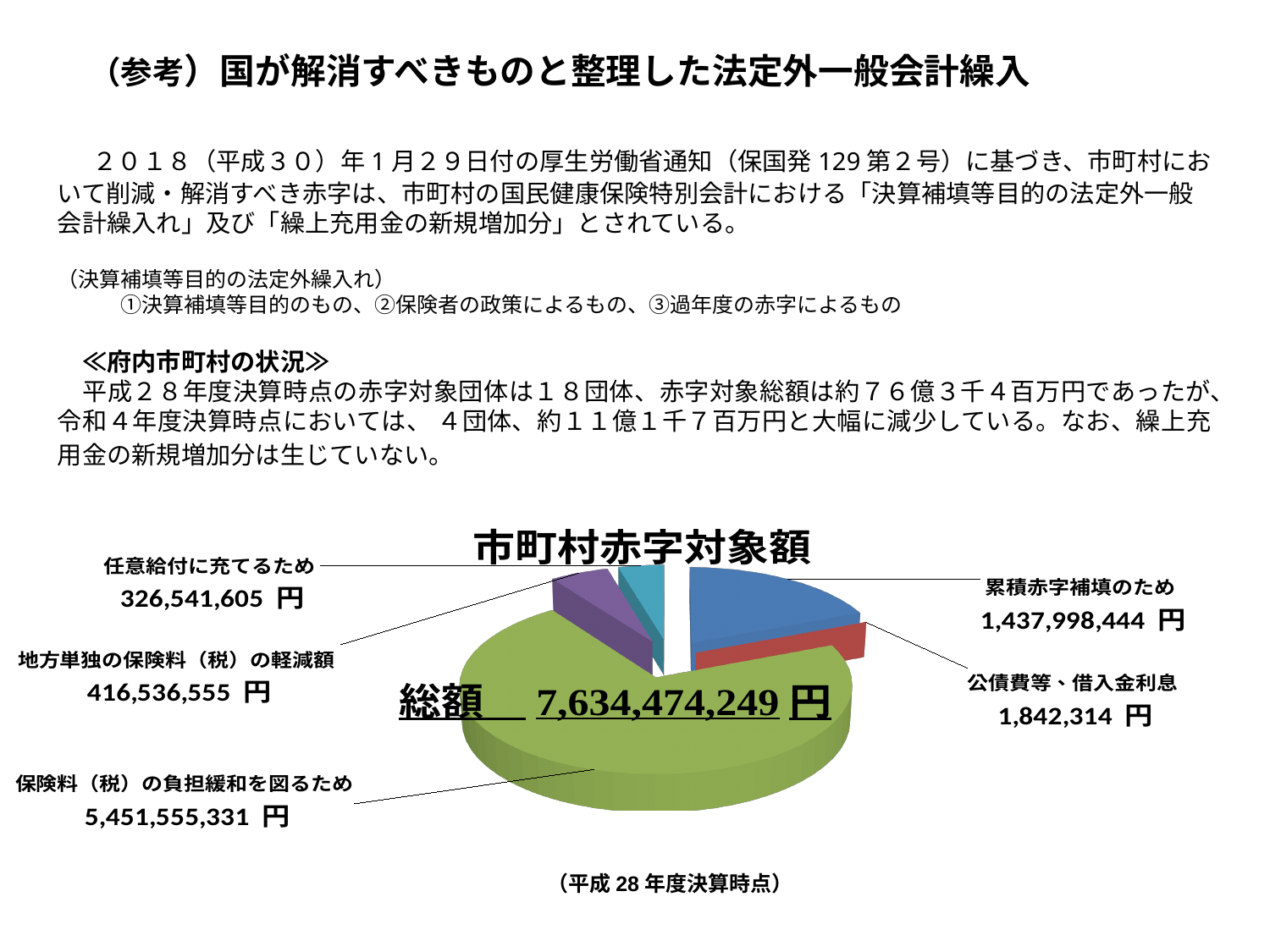
Which is larger, 累積赤字補填のため or 地方単独の保険料（税）の軽減額? 累積赤字補填のため What is the total amount (総額) shown on the chart? 7,634,474,249 円 What is the value for 任意給付に充てるため? 326,541,605 円 What type of chart is shown on the slide? Pie chart What is the difference between 地方単独の保険料（税）の軽減額 and 任意給付に充てるため? 89,994,950 円 Which category has the largest value in the pie chart? 保険料（税）の負担緩和を図るため What is the title of the chart? 市町村赤字対象額 What is the value for 公債費等、借入金利息? 1,842,314 円 What is the value for 累積赤字補填のため? 1,437,998,444 円 What is the value for 保険料（税）の負担緩和を図るため? 5,451,555,331 円 Which category has the smallest value in the pie chart? 公債費等、借入金利息 How many slices does the pie chart have? 5